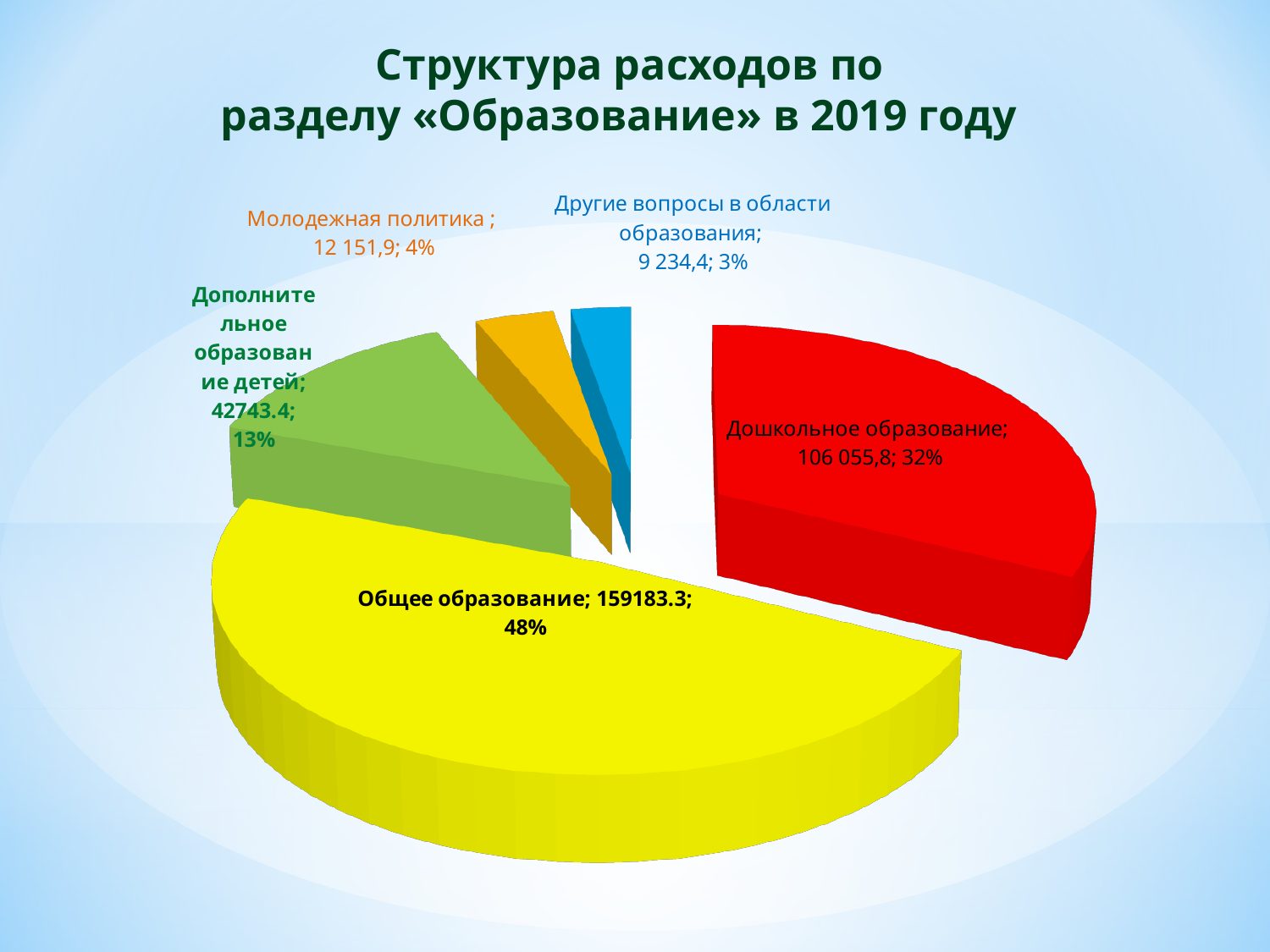
What share of the pie does Общее образование have? 48% What share of the pie does Дополнительное образование детей have? 13% What value is shown for Дошкольное образование? 106 055,8 What value is shown for Молодежная политика? 12 151,9 What is the difference in percentage points between the shares of Общее образование and Дошкольное образование? 16% Which category has the smallest share of the pie? Другие вопросы в области образования Which category has the largest share of the pie? Общее образование Which has a larger share: Дополнительное образование детей or Молодежная политика? Дополнительное образование детей What value is shown for Другие вопросы в области образования? 9 234,4 How many slices does the pie chart have? 5 What kind of chart is shown on the slide? pie chart What is the title of the chart on the slide? Структура расходов по разделу «Образование» в 2019 году